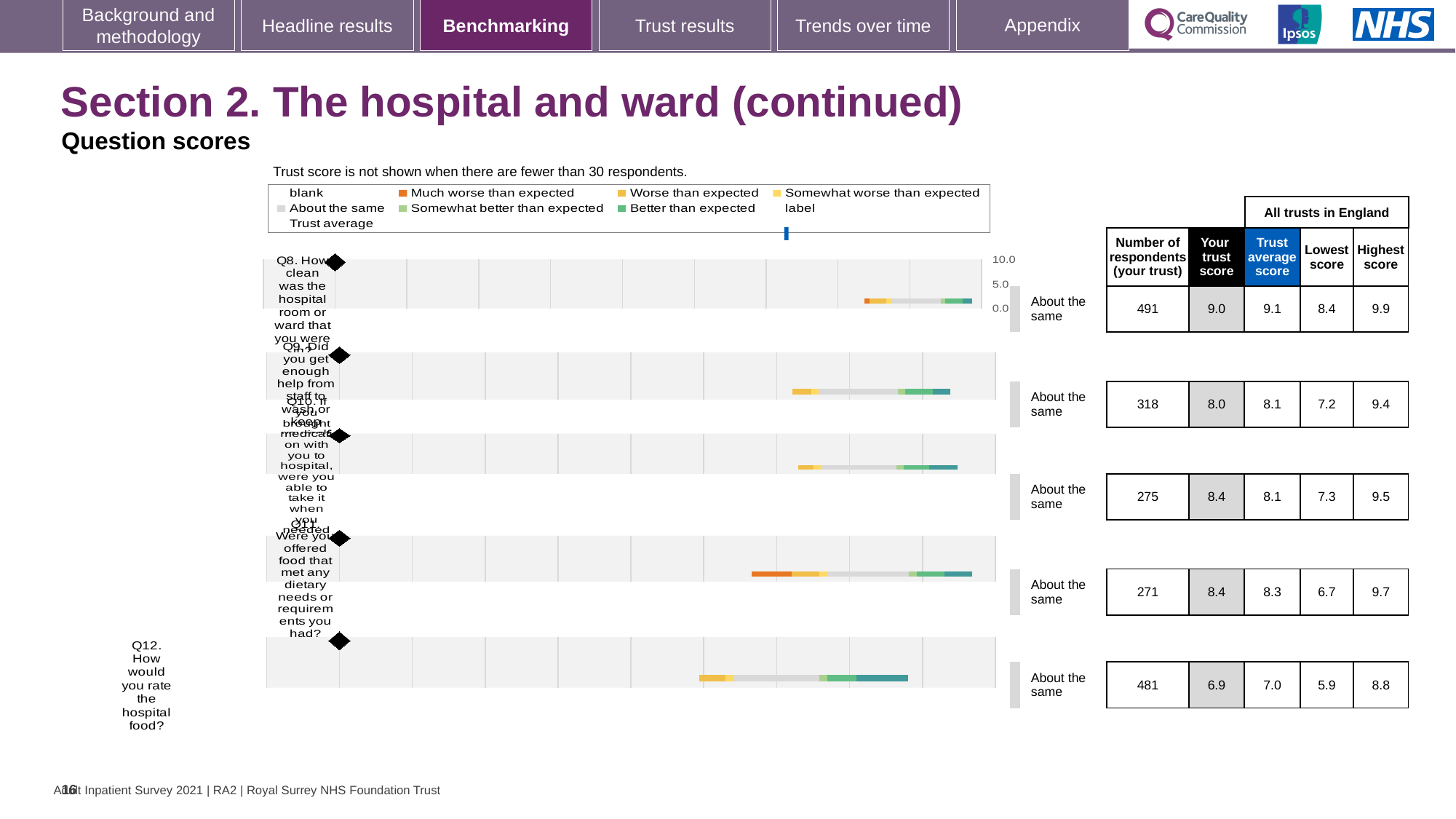
Which question has the lowest 'Your trust score'? Q12 Which question has the highest 'Your trust score'? Q8 What benchmark category is shown for Q9 (enough help from staff to wash or keep clean)? About the same What is the lowest score across all trusts in England for Q12? 5.9 What is the trust average score for Q11 (offered food that met any dietary needs)? 8.3 For Q10, which is larger: the 'Your trust score' or the trust average score? Your trust score What is the 'Your trust score' for Q8 (how clean was the hospital room or ward)? 9.0 How many questions (Q8 to Q12) are plotted in the chart? 5 What is the number of respondents for Q12 (how would you rate the hospital food)? 481 What is the difference between the highest score (9.9) and the lowest score (8.4) for Q8? 1.5 What colour represents 'Much worse than expected' in the legend? Orange What kind of chart is used to show the question scores on this slide? bar chart